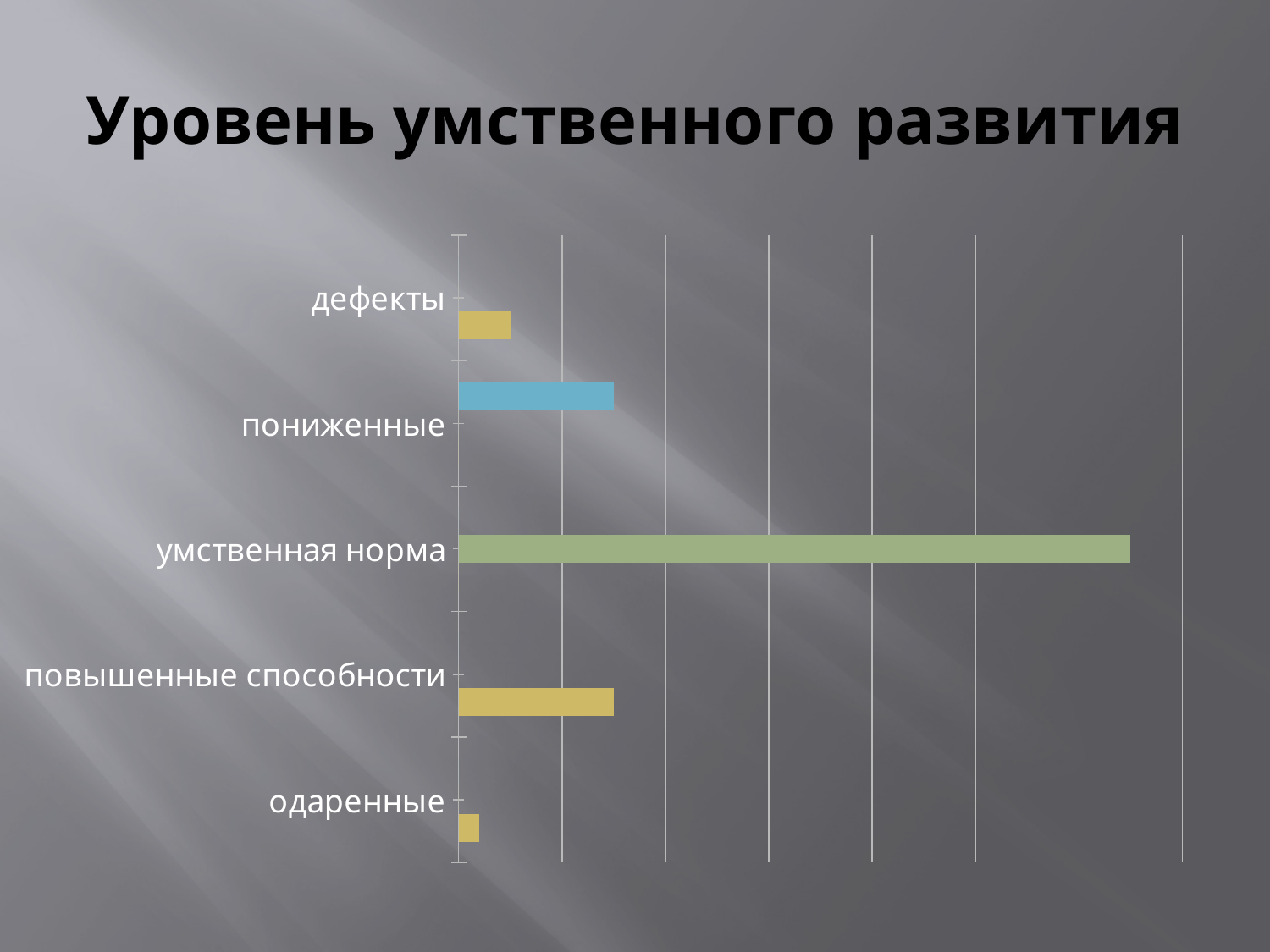
How many categories are plotted in the chart? 5 Which category has the highest value in the chart? умственная норма Which is larger, the value for повышенные способности or the value for одаренные? повышенные способности Which is larger, the value for дефекты or the value for одаренные? дефекты Which is larger, the value for пониженные or the value for дефекты? пониженные Which category has the lowest value in the chart? одаренные What colour is the bar for умственная норма? green What is the title shown above the chart? Уровень умственного развития What kind of chart is shown on the slide? bar chart